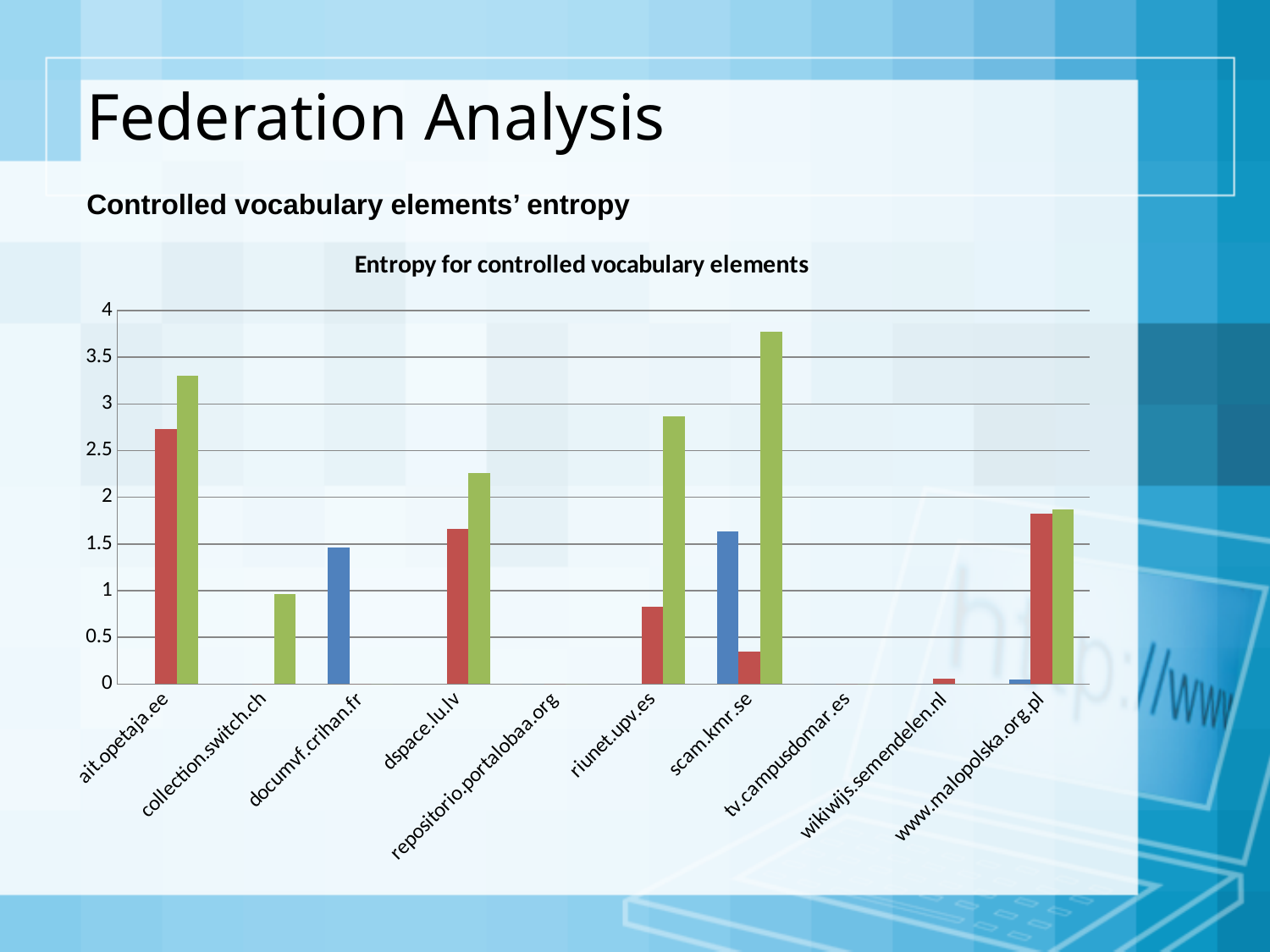
Is the green bar for ait.opetaja.ee greater or less than 3? greater Is the green bar for dspace.lu.lv greater or less than 2? greater Which category has the tallest bar in the chart? scam.kmr.se How many categories are shown on the x axis of the chart? 10 Is the red bar for ait.opetaja.ee greater or less than 2.5? greater What kind of chart is shown on the slide? bar chart Which is larger, the red bar for dspace.lu.lv or the red bar for riunet.upv.es? dspace.lu.lv Which is larger, the green bar for ait.opetaja.ee or the green bar for riunet.upv.es? ait.opetaja.ee How many differently coloured bar series are plotted in the chart? 3 What is the title of the chart? Entropy for controlled vocabulary elements